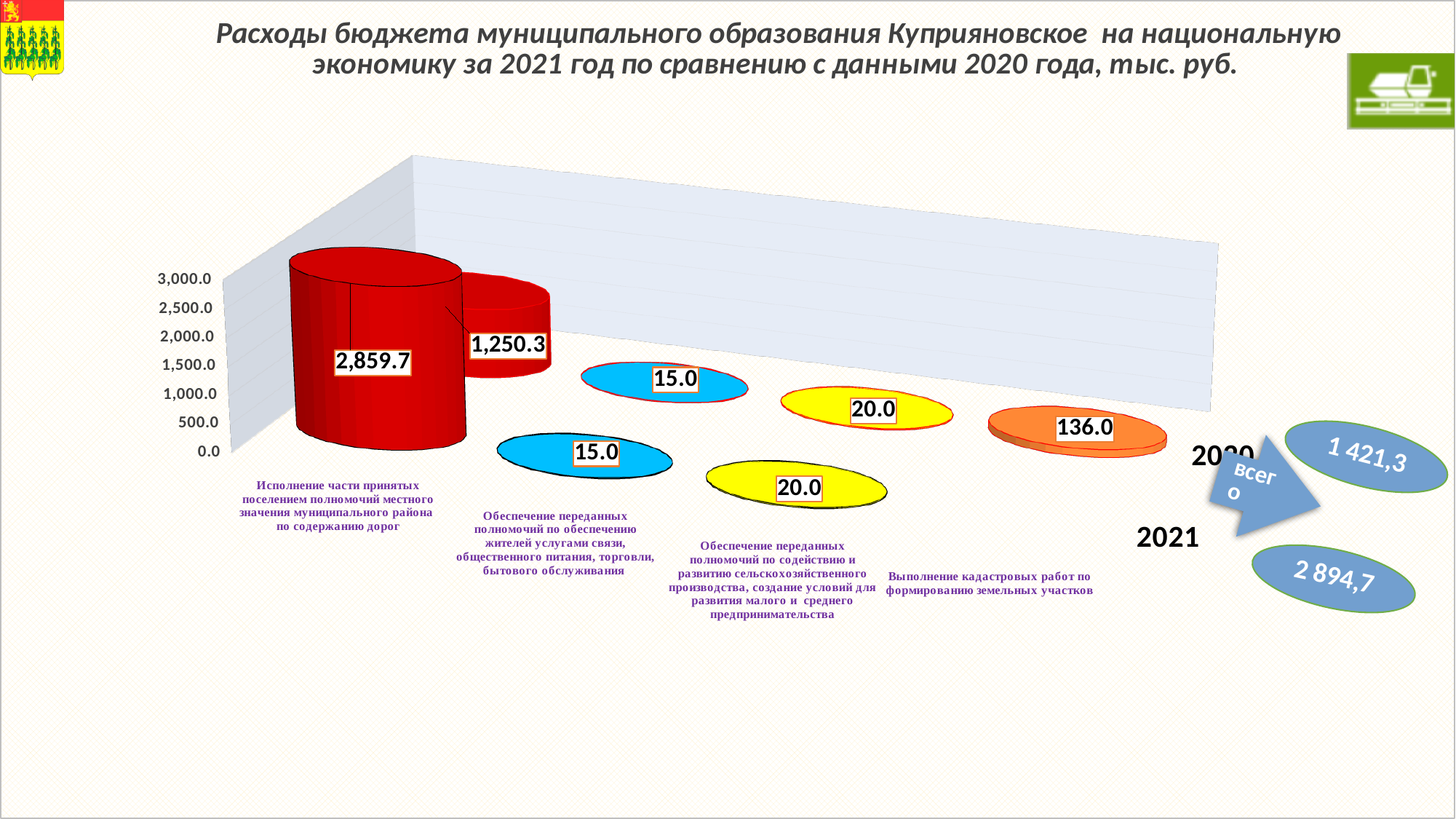
What is the 2020 value for support of agricultural production and small and medium business (Обеспечение переданных полномочий по содействию и развитию сельскохозяйственного производства...)? 20.0 What is the 2021 value for road maintenance (Исполнение части принятых поселением полномочий ... по содержанию дорог)? 2,859.7 What is the 2020 value for cadastral works (Выполнение кадастровых работ по формированию земельных участков)? 136.0 Which category has the highest value in 2021? Исполнение части принятых поселением полномочий местного значения муниципального района по содержанию дорог What is the 2020 value for road maintenance (содержание дорог)? 1,250.3 Which is larger: the 2020 value for cadastral works (136.0) or the 2020 value for agricultural support (20.0)? Cadastral works (136.0) What is the 2021 value for providing residents with communication, catering, trade and consumer services (Обеспечение переданных полномочий по обеспечению жителей услугами связи...)? 15.0 What is the total (всего) for 2020 shown on the slide? 1 421,3 How many years (series) are compared in the chart? 2 What is the total (всего) for 2021 shown on the slide? 2 894,7 Is the 2021 value for road maintenance greater or less than 2,500.0? greater By how much did spending on road maintenance (содержание дорог) increase from 2020 to 2021? 1,609.4